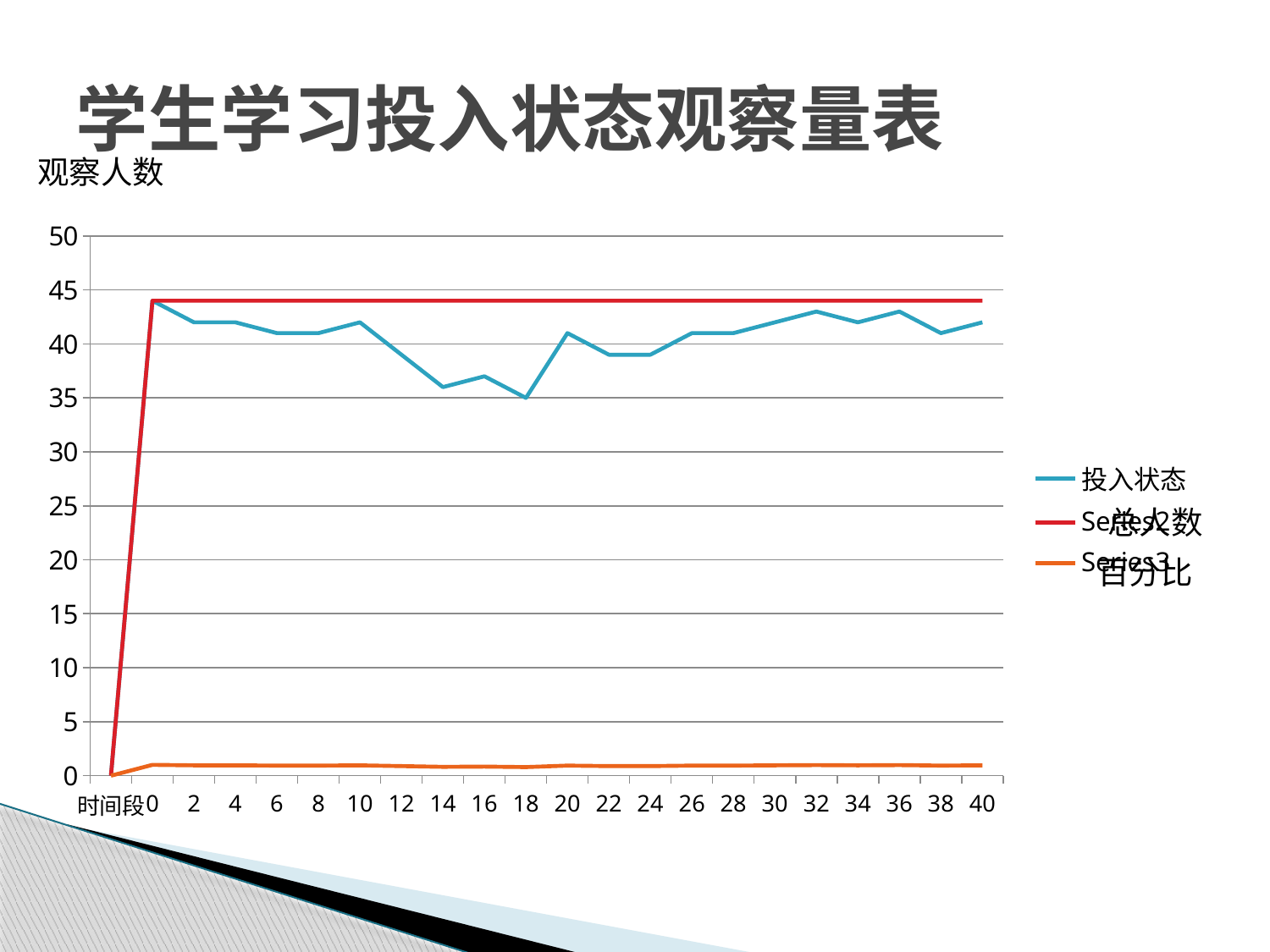
At which 时间段 does the 投入状态 line reach its lowest value? 18 How many series does the legend list? 3 Is the value of the red line (总人数) at 时间段 20 greater or less than 40? greater What is the label on the vertical axis of the chart? 观察人数 Is the value of the orange line (百分比) at 时间段 10 greater or less than 5? less Is the value of 投入状态 at 时间段 32 greater or less than 40? greater What is the title of the slide above the chart? 学生学习投入状态观察量表 Which is higher for 投入状态: the value at 时间段 10 or at 时间段 14? 时间段 10 At 时间段 18, which line is higher, 投入状态 or the red line (总人数)? the red line (总人数) Does the 投入状态 line rise or fall between 时间段 10 and 时间段 14? fall What kind of chart is shown on the slide? line chart